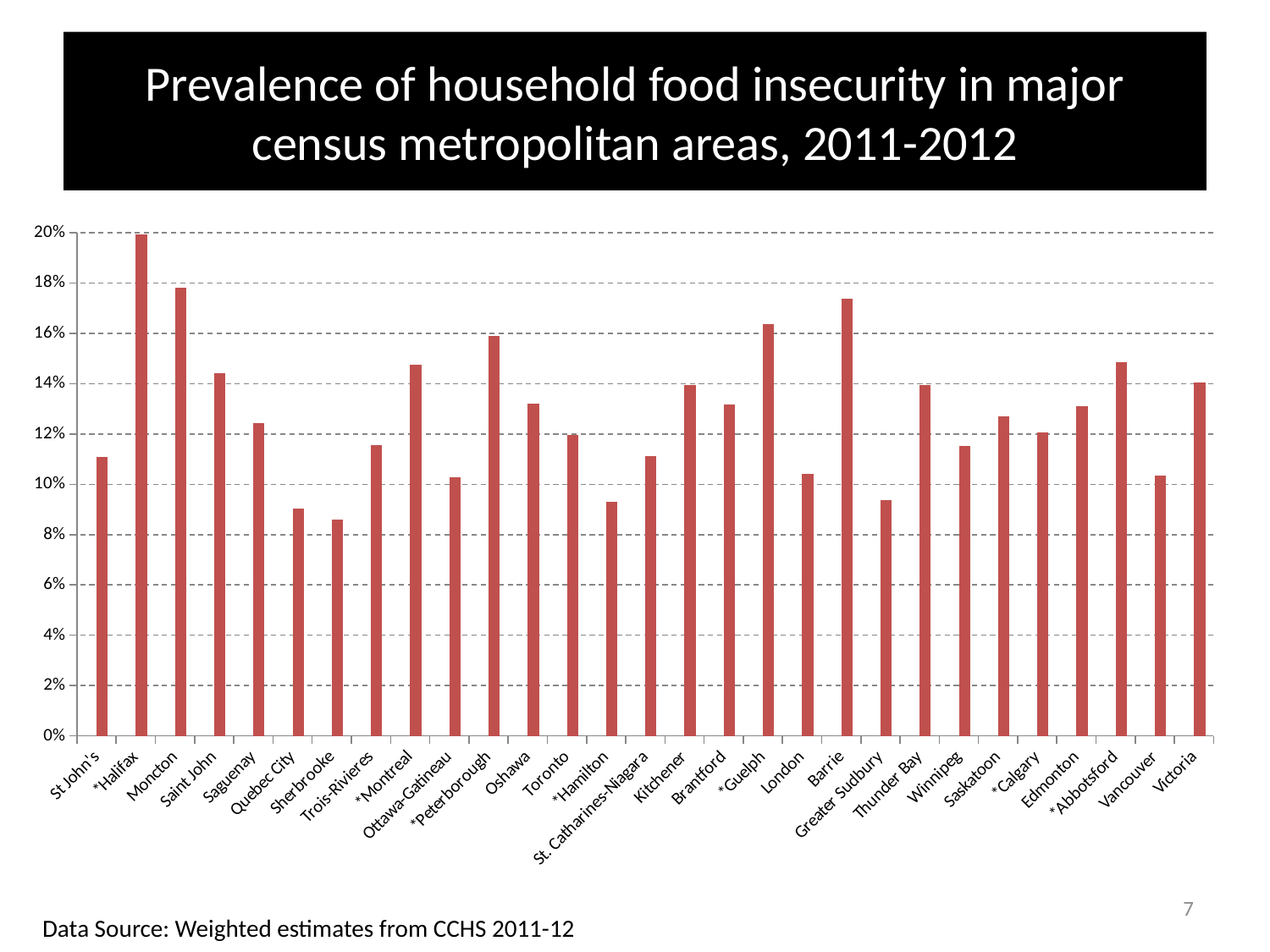
Is the value for Moncton greater or less than 16%? greater What kind of chart is shown on the slide? bar chart Which has a higher prevalence of household food insecurity, Barrie or London? Barrie Which census metropolitan area has the highest prevalence of household food insecurity? *Halifax Is the value for Victoria greater or less than 12%? greater Is the value for Barrie greater or less than 16%? greater How many census metropolitan areas are plotted on the chart? 29 Which has a higher prevalence of household food insecurity, *Halifax or Moncton? *Halifax What is the title of the chart? Prevalence of household food insecurity in major census metropolitan areas, 2011-2012 Which census metropolitan area has the lowest prevalence of household food insecurity? Sherbrooke